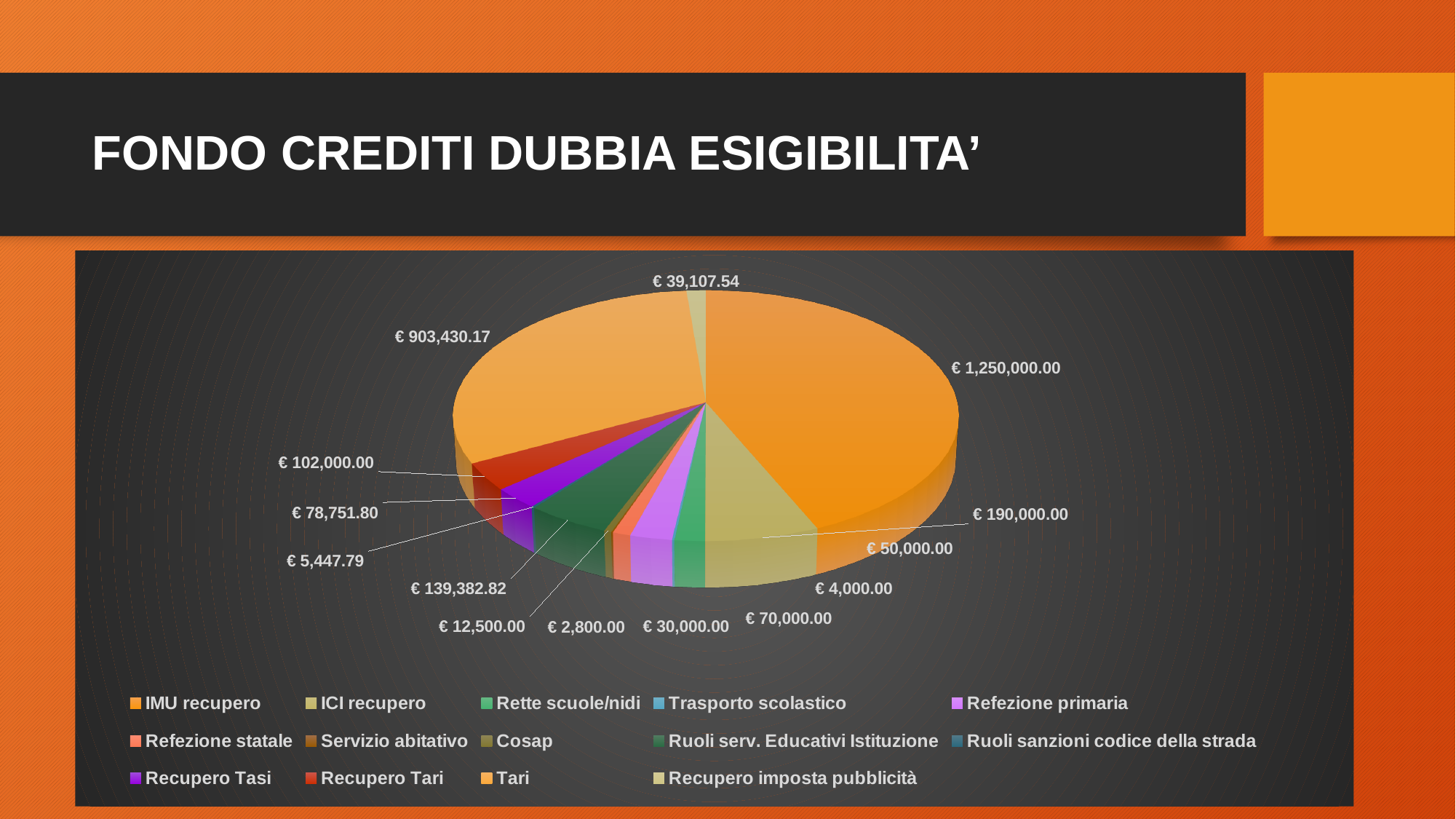
What is the value shown for IMU recupero? € 1,250,000.00 How many categories does the legend of the pie chart list? 14 What is the value shown for Tari? € 903,430.17 What type of chart is shown on the slide? Pie chart What is the difference between the values for IMU recupero and Tari? € 346,569.83 What is the smallest value labelled on the pie chart? € 2,800.00 What is the value shown for Recupero Tari? € 102,000.00 What is the value shown for Recupero Tasi? € 78,751.80 Which category has the largest slice of the pie? IMU recupero What is the title of the slide containing the chart? FONDO CREDITI DUBBIA ESIGIBILITA' Which is larger, the value for Recupero Tari or the value for Recupero Tasi? Recupero Tari What is the value shown for Recupero imposta pubblicità? € 39,107.54